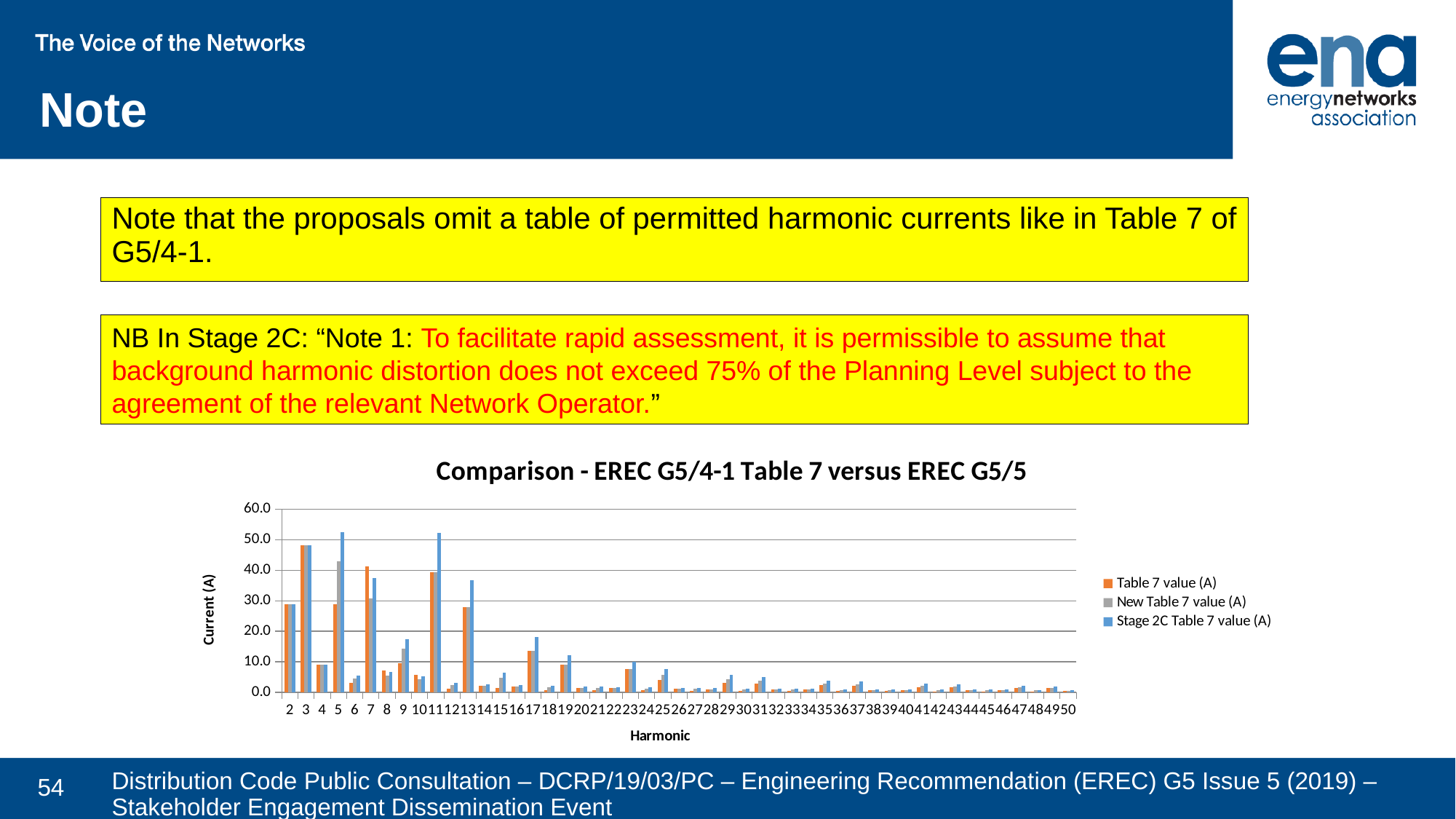
What is the title of the chart? Comparison - EREC G5/4-1 Table 7 versus EREC G5/5 How many series does the legend of the chart list? 3 Is the Table 7 value (A) for harmonic 3 greater or less than 40.0? greater Do the Table 7 value (A) bars generally rise or fall as the harmonic number increases along the x axis? fall What kind of chart is shown on the slide? bar chart How many harmonic categories are shown along the x axis of the chart? 49 Is the Stage 2C Table 7 value (A) for harmonic 5 greater or less than 50.0? greater Is the Stage 2C Table 7 value (A) for harmonic 17 greater or less than 20.0? less At harmonic 5, which is larger: the Table 7 value (A) or the Stage 2C Table 7 value (A)? Stage 2C Table 7 value (A) What is the label of the vertical axis of the chart? Current (A)